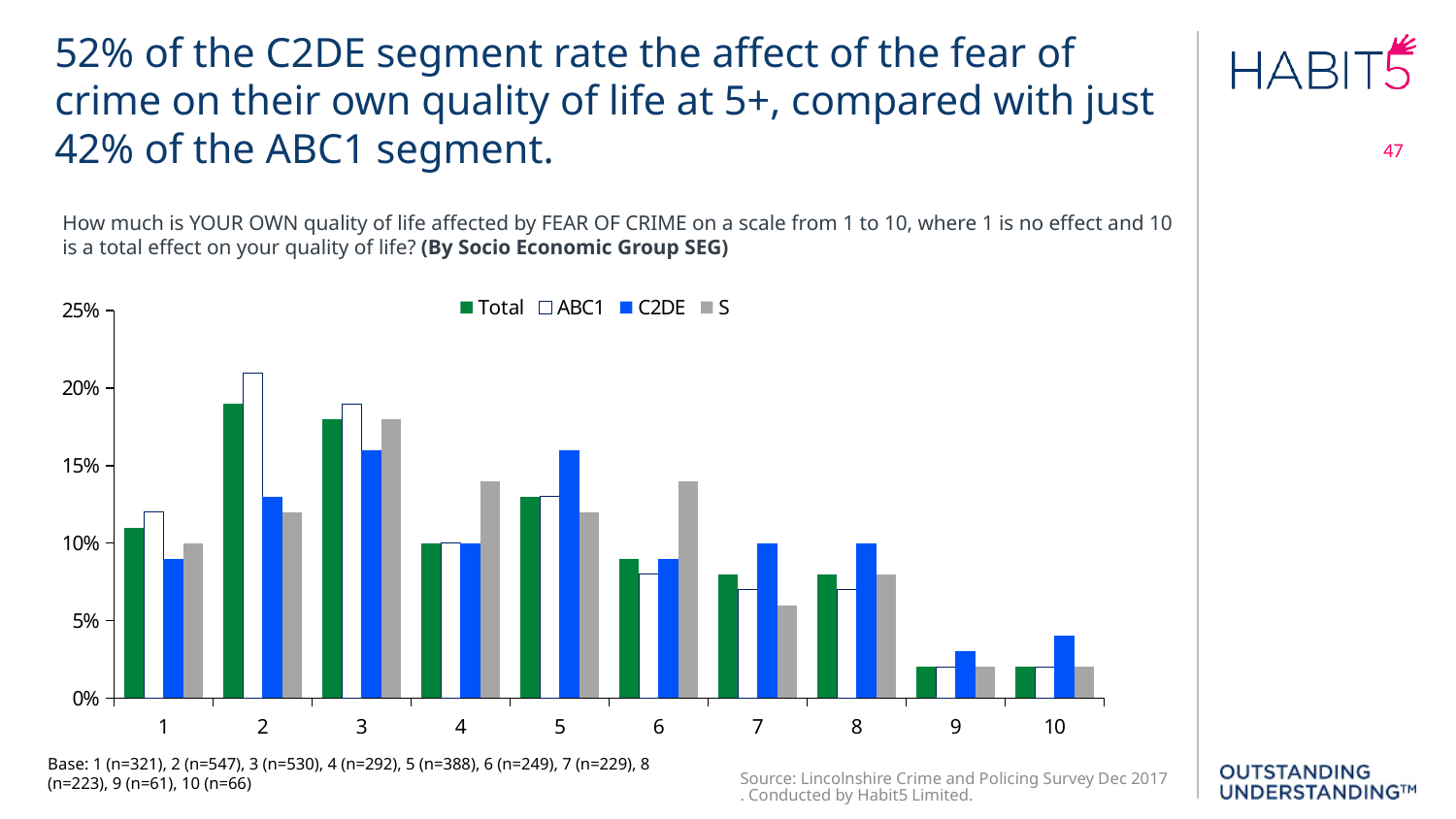
Is the value for ABC1 at scale point 2 greater or less than 20%? greater Is the value for S at scale point 10 greater or less than 5%? less How many scale-point categories are shown on the x axis? 10 Is the value for C2DE at scale point 5 greater or less than 15%? greater Which scale point has the highest value for the Total series? 2 At scale point 2, which is larger: the value for ABC1 or the value for C2DE? ABC1 What kind of chart is shown on the slide? bar chart Does the Total series rise or fall from scale point 2 to scale point 4? fall Which series is shown in blue in the legend? C2DE At scale point 6, which is larger: the value for S or the value for ABC1? S How many series does the legend list? 4 Which scale point has the highest value for the ABC1 series? 2